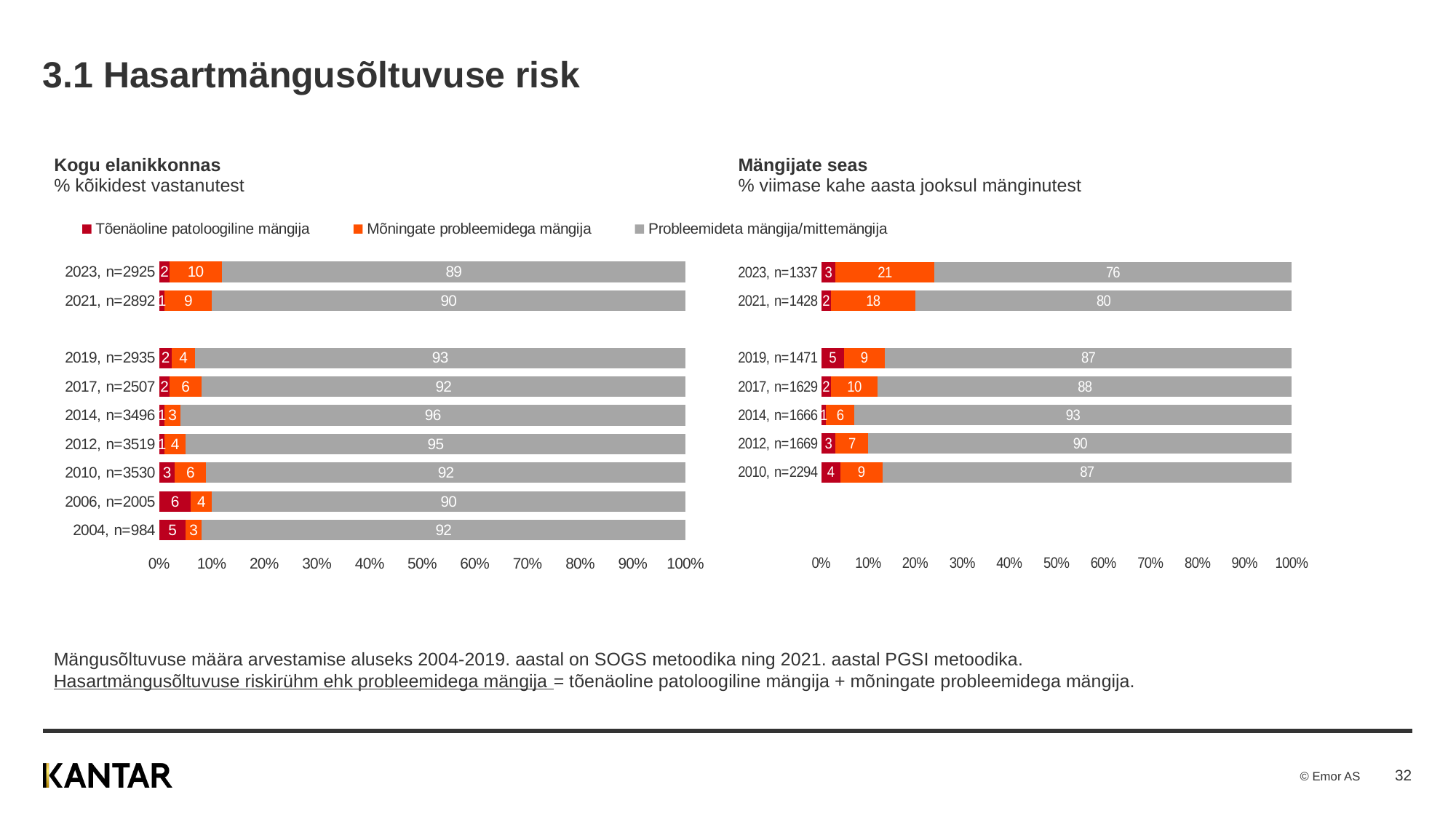
In the 'Mängijate seas' chart, what is the value for 'Mõningate probleemidega mängija' in 2023, n=1337? 21 In the 'Mängijate seas' chart, what is the difference between the 'Mõningate probleemidega mängija' values for 2023, n=1337 and 2021, n=1428? 3 How many series does the legend list? 3 In the 'Kogu elanikkonnas' chart, which is larger: the 'Tõenäoline patoloogiline mängija' value for 2006, n=2005 or for 2010, n=3530? 2006, n=2005 In the 'Kogu elanikkonnas' chart, what is the total of the stacked bar for 2021, n=2892? 100 How many year categories are shown in the 'Kogu elanikkonnas' chart? 9 In the 'Kogu elanikkonnas' chart, what is the value for 'Probleemideta mängija/mittemängija' in 2023, n=2925? 89 What type of chart is the 'Mängijate seas' chart? Stacked bar chart In the 'Mängijate seas' chart, which year has the lowest value for 'Probleemideta mängija/mittemängija'? 2023, n=1337 In the 'Mängijate seas' chart, what is the value for 'Tõenäoline patoloogiline mängija' in 2019, n=1471? 5 How many year categories are shown in the 'Mängijate seas' chart? 7 In the 'Kogu elanikkonnas' chart, which year has the highest value for 'Probleemideta mängija/mittemängija'? 2014, n=3496